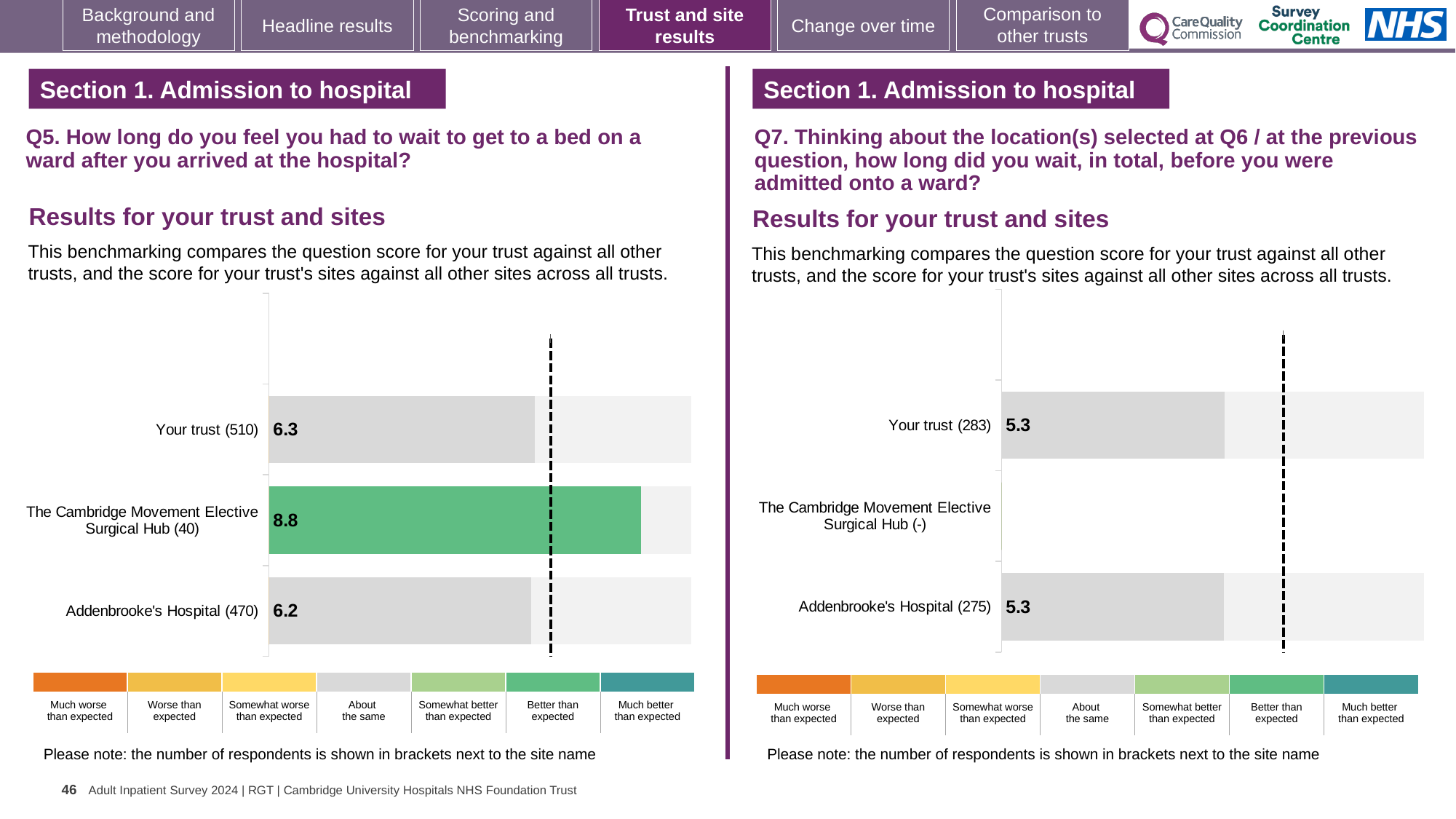
What kind of chart is the Q5 chart on the left? Bar chart In the Q5 chart on the left, what is the difference between the score for The Cambridge Movement Elective Surgical Hub (40) and the score for Addenbrooke's Hospital (470)? 2.6 In the Q7 chart on the right, what is the score for Your trust (283)? 5.3 In the Q7 chart on the right, what is the score for Addenbrooke's Hospital (275)? 5.3 In the Q5 chart on the left, what is the score for The Cambridge Movement Elective Surgical Hub (40)? 8.8 How many rows (trust and sites) are listed in the Q7 chart on the right? 3 In the Q5 chart on the left, what is the score for Your trust (510)? 6.3 In the Q5 chart on the left, which bar is coloured green? The Cambridge Movement Elective Surgical Hub (40) In the Q5 chart on the left, which has the larger score: Your trust (510) or The Cambridge Movement Elective Surgical Hub (40)? The Cambridge Movement Elective Surgical Hub (40) In the Q5 chart on the left, which site or trust has the highest score? The Cambridge Movement Elective Surgical Hub (40) In the Q5 chart on the left, what is the score for Addenbrooke's Hospital (470)? 6.2 In the Q5 chart on the left, which site or trust has the lowest score? Addenbrooke's Hospital (470)